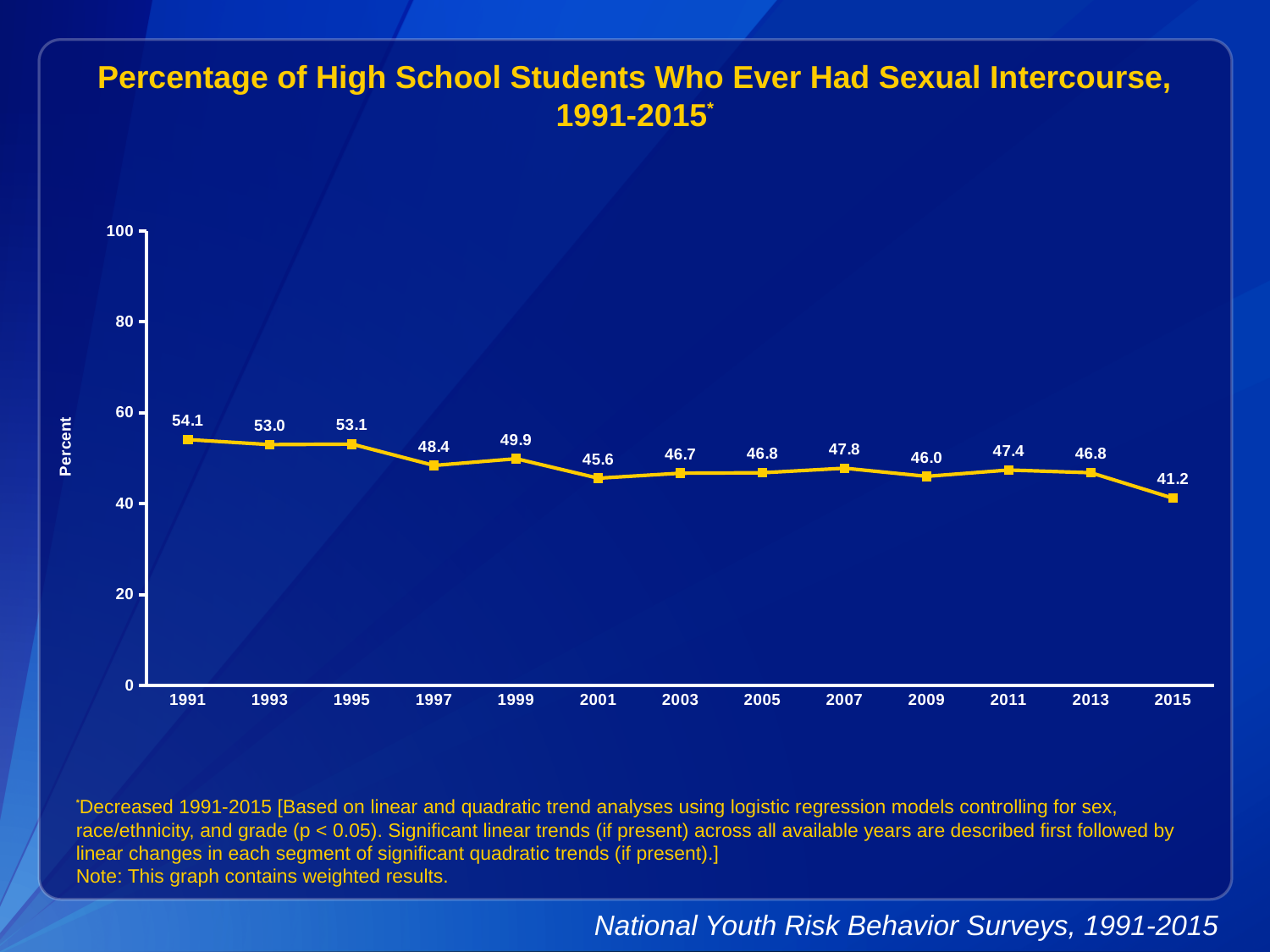
Which year had a higher percentage, 1997 or 1999? 1999 What is the difference between the 1991 value and the 2015 value? 12.9 How many years are plotted on the chart? 13 What was the percentage of high school students who ever had sexual intercourse in 1991? 54.1 What is the label on the y axis? Percent Which year had the highest percentage? 1991 Overall, do the values rise or fall from 1991 to 2015? fall Which year had the lowest percentage? 2015 What kind of chart is shown on the slide? line chart Is the value for 2007 greater or less than 60? less What was the percentage in 2001? 45.6 What was the percentage in 2015? 41.2